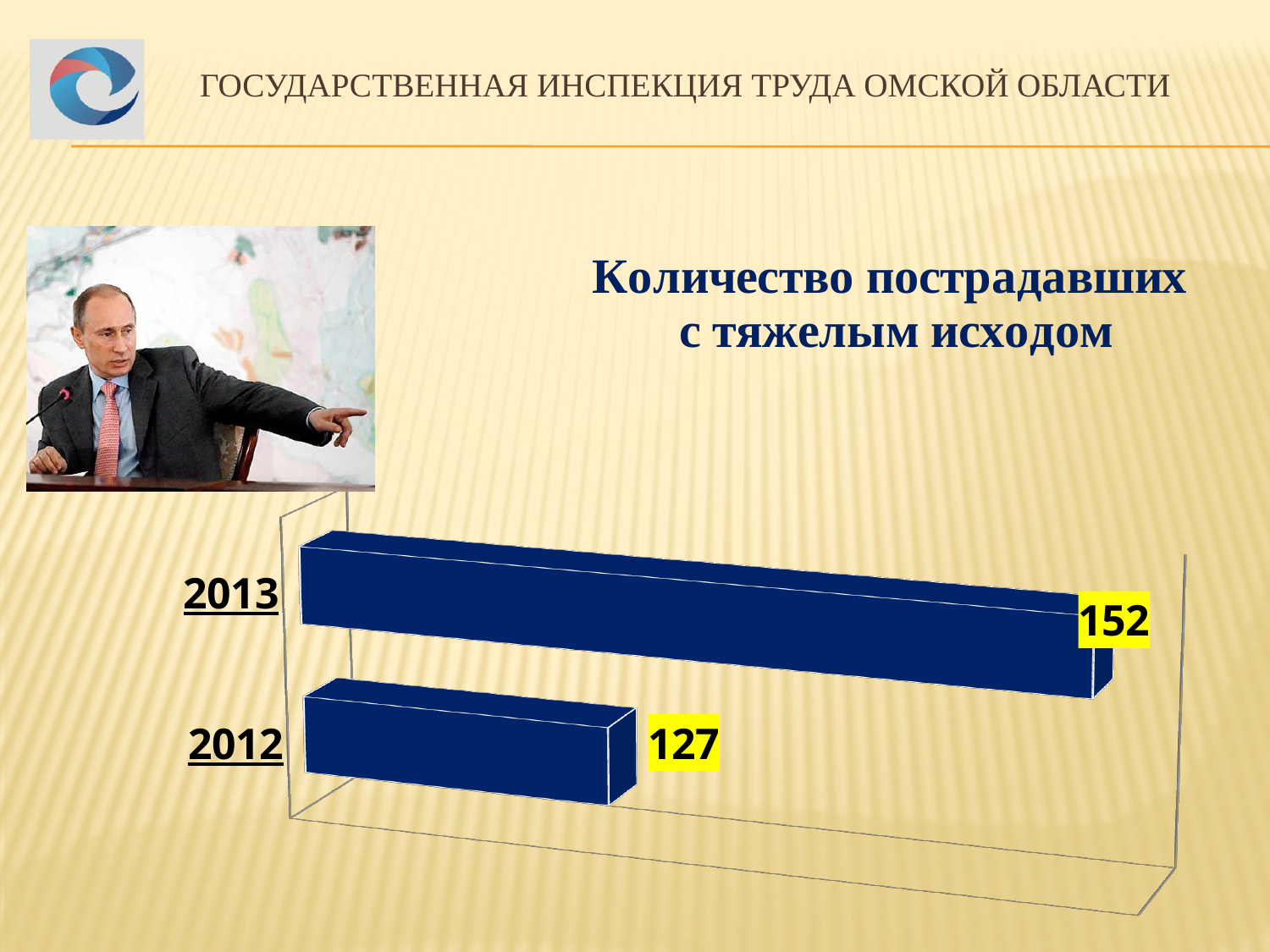
Which year has the higher number of victims with severe outcome? 2013 Did the number of victims with severe outcome rise or fall from 2012 to 2013? rise What is the value for 2012? 127 How many categories (years) are shown in the chart? 2 What is the difference between the 2013 and 2012 values? 25 What is the title of the chart? Количество пострадавших с тяжелым исходом Is the value for 2013 larger or smaller than the value for 2012? larger What colour are the bars in the chart? dark blue What kind of chart is shown on the slide? bar chart What is the value for 2013? 152 Which year has the lower value? 2012